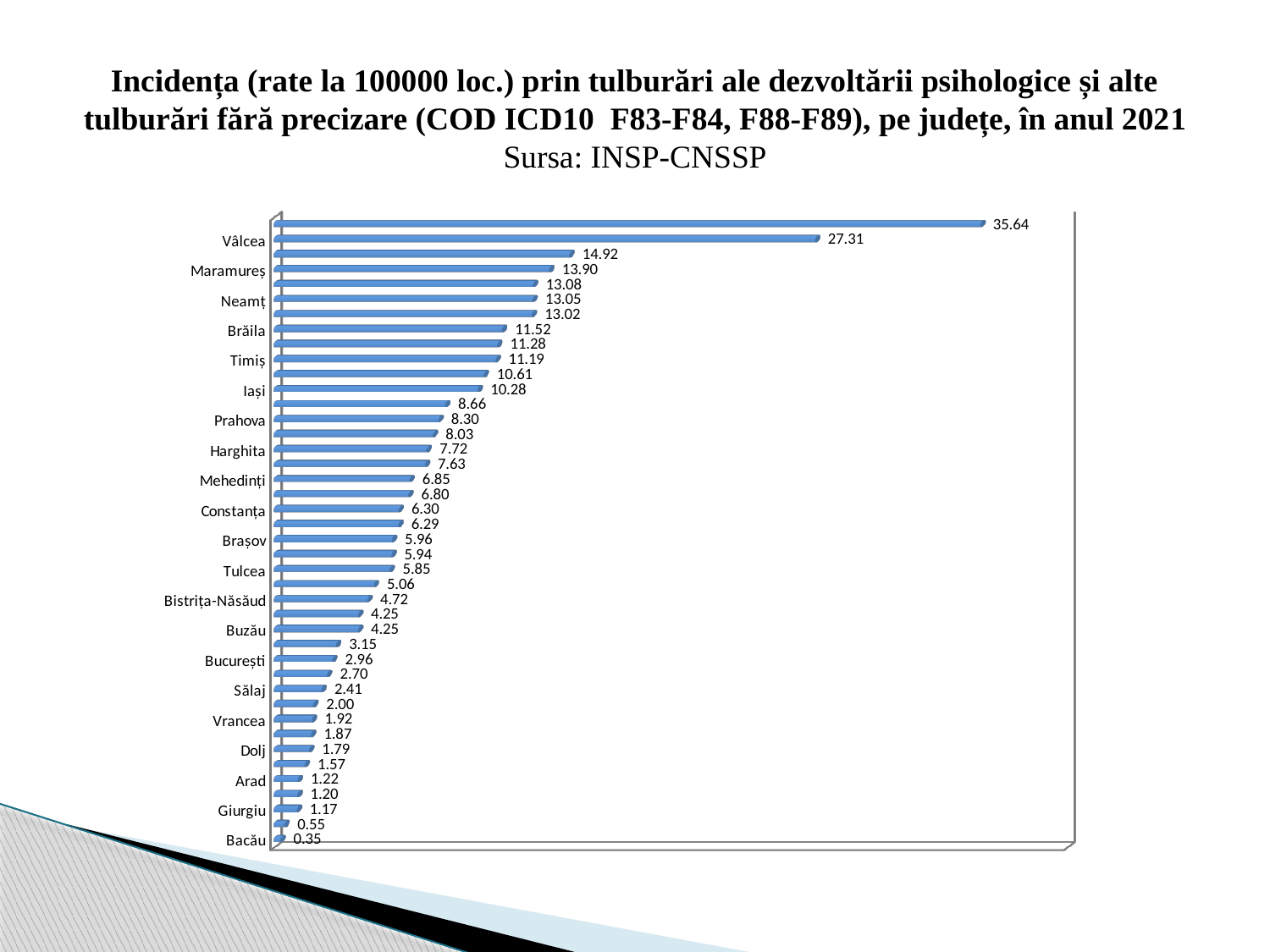
How many bars are plotted on the chart? 42 What is the value for Timiș? 11.19 What is the value for Iași? 10.28 What source is cited for the chart data? INSP-CNSSP Which has a larger value, Prahova or Harghita? Prahova Which labelled county has the lowest value? Bacău Which has a larger value, Constanța or Brașov? Constanța What is the highest value shown on the chart? 35.64 What is the value for Bacău? 0.35 What is the difference between the values for Vâlcea and Maramureș? 13.41 What kind of chart is shown on the slide? Bar chart What is the value for Vâlcea? 27.31